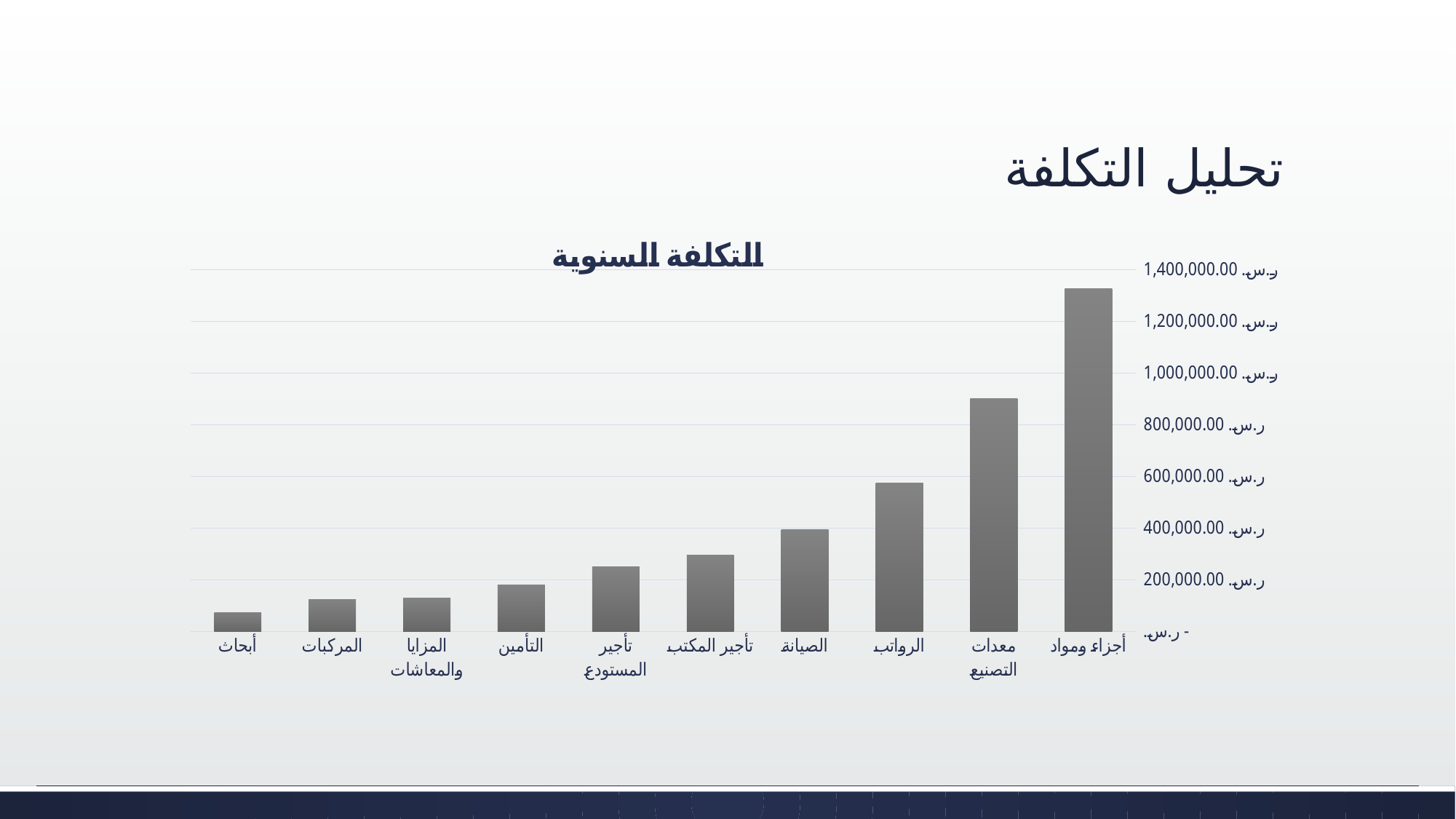
Which category has the lowest annual cost? أبحاث Is the value for الرواتب greater or less than 400,000.00? greater How many categories are plotted in the chart? 10 What is the title of the chart? التكلفة السنوية What kind of chart is shown on the slide? bar chart Is the value for أبحاث greater or less than 200,000.00? less Is the value for أجزاء ومواد greater or less than 1,200,000.00? greater Which category has the highest annual cost? أجزاء ومواد Do the bar values rise or fall moving from left to right along the x axis? rise Which has a larger annual cost, الرواتب or الصيانة? الرواتب